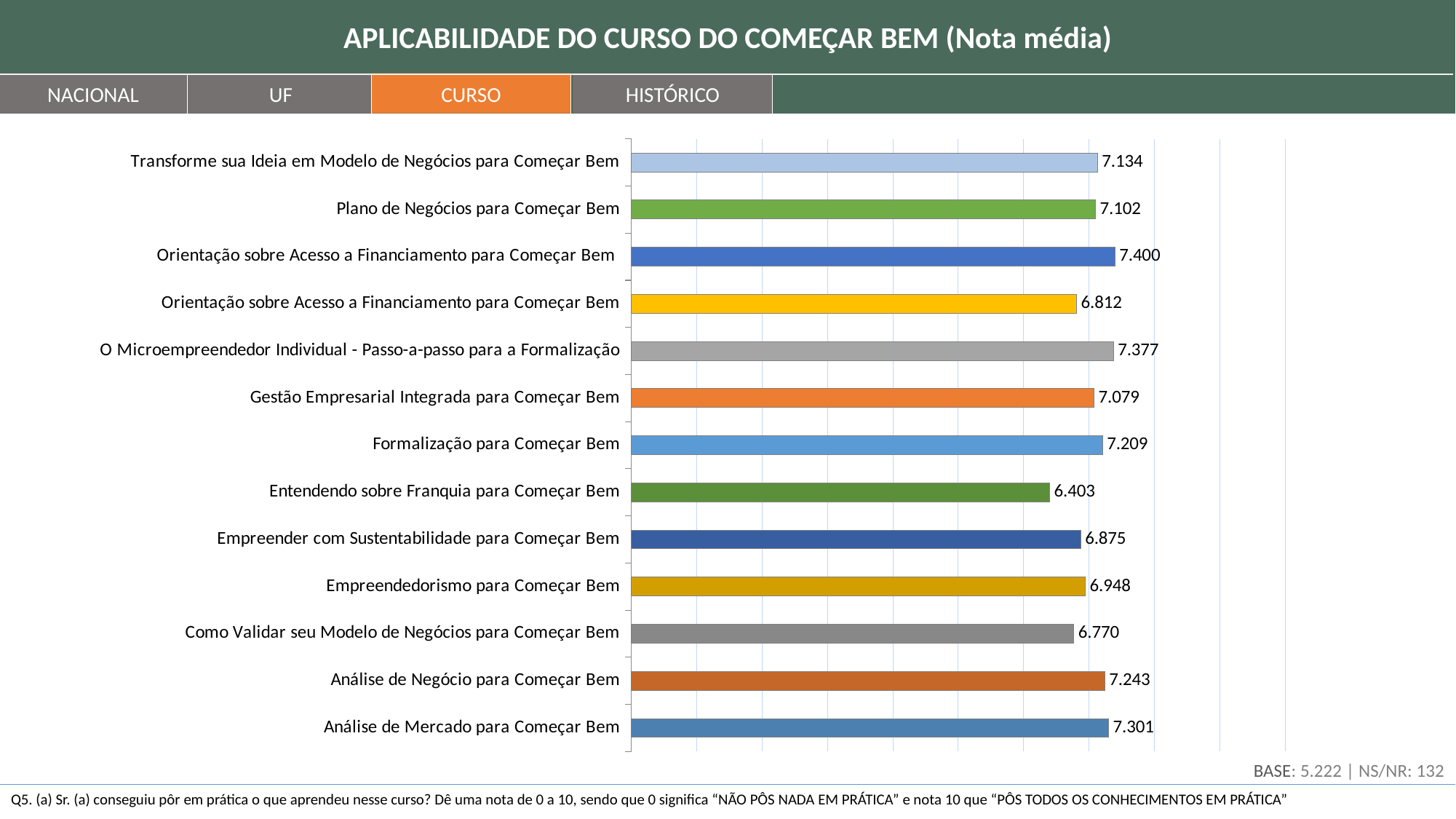
What is the highest value shown in the chart? 7.400 What is the value for Empreender com Sustentabilidade para Começar Bem? 6.875 What is the value for Análise de Mercado para Começar Bem? 7.301 What kind of chart is shown on the slide? Bar chart Which category has the lowest value? Entendendo sobre Franquia para Começar Bem What is the difference between Formalização para Começar Bem and Gestão Empresarial Integrada para Começar Bem? 0.130 What is the difference between Análise de Mercado para Começar Bem and Análise de Negócio para Começar Bem? 0.058 What is the value for Transforme sua Ideia em Modelo de Negócios para Começar Bem? 7.134 How many bars are shown in the chart? 13 Which is larger, Empreendedorismo para Começar Bem or Como Validar seu Modelo de Negócios para Começar Bem? Empreendedorismo para Começar Bem What is the value for O Microempreendedor Individual - Passo-a-passo para a Formalização? 7.377 What is the value for Plano de Negócios para Começar Bem? 7.102